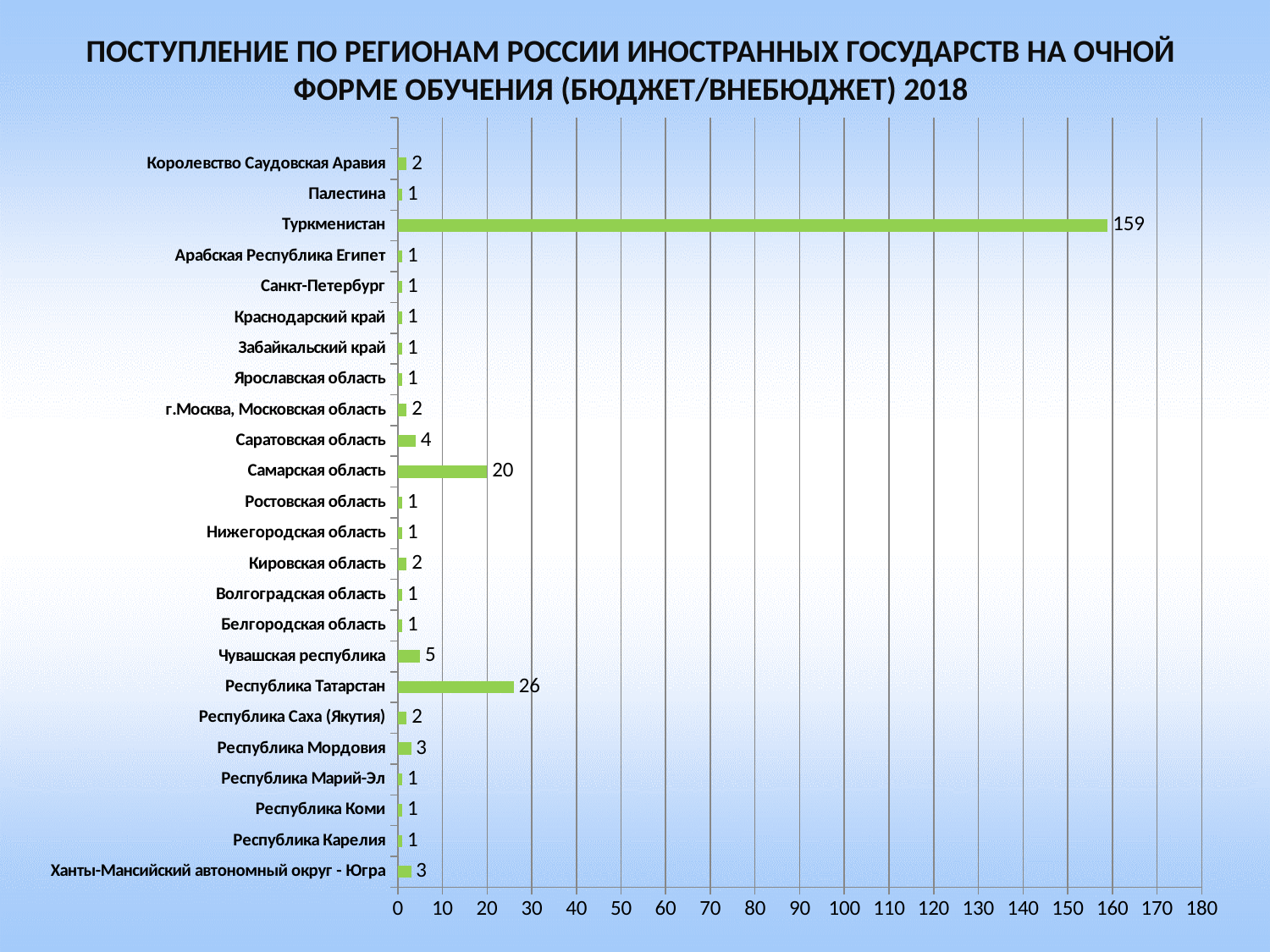
What is the value for Саратовская область? 4 Which is larger, the value for Республика Мордовия or the value for Чувашская республика? Чувашская республика What kind of chart is shown on the slide? bar chart Is the value for Туркменистан greater or less than 150? greater What is the value for Республика Татарстан? 26 How many categories are shown on the chart? 24 Which category has the highest value? Туркменистан What is the value for Туркменистан? 159 What is the value for Самарская область? 20 What is the difference between the values for Республика Татарстан and Самарская область? 6 What is the value for Чувашская республика? 5 What is the difference between the values for Туркменистан and Республика Татарстан? 133